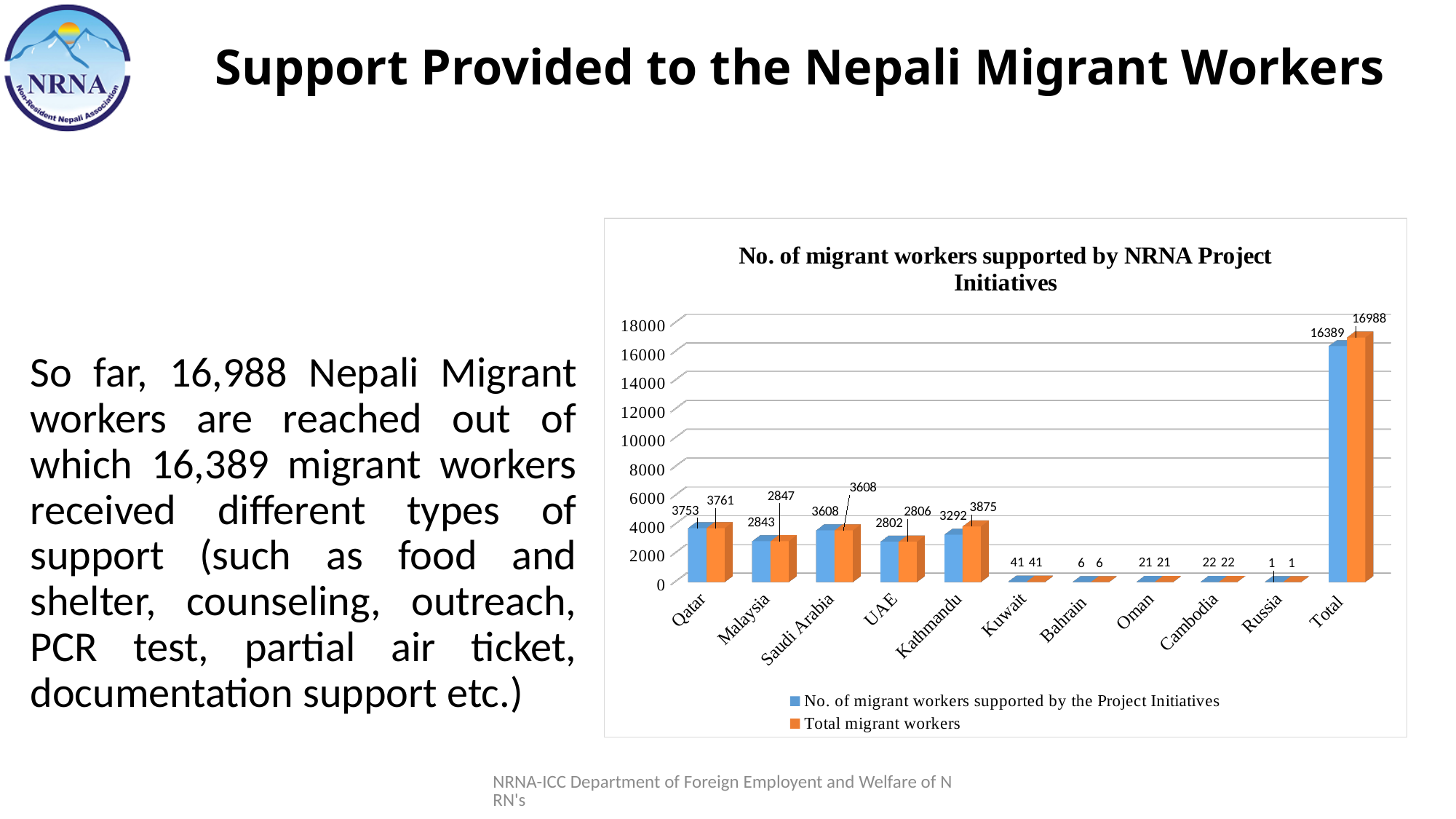
What is the difference between the two series values for the Total category? 599 Which category has the lowest 'Total migrant workers' value? Russia Which is larger: the 'Total migrant workers' value for Qatar or for Saudi Arabia? Qatar Excluding the Total category, which country has the highest 'Total migrant workers' value? Kathmandu How many categories are shown on the x axis? 11 How many series does the legend list? 2 What is the value for Qatar in the 'No. of migrant workers supported by the Project Initiatives' series? 3753 What type of chart is shown on the slide? Bar chart What is the 'Total migrant workers' value for Kathmandu? 3875 What is the 'Total migrant workers' value for the Total category? 16988 What is the value for Bahrain in the 'No. of migrant workers supported by the Project Initiatives' series? 6 What is the difference between the 'Total migrant workers' value and the 'No. of migrant workers supported by the Project Initiatives' value for Kathmandu? 583